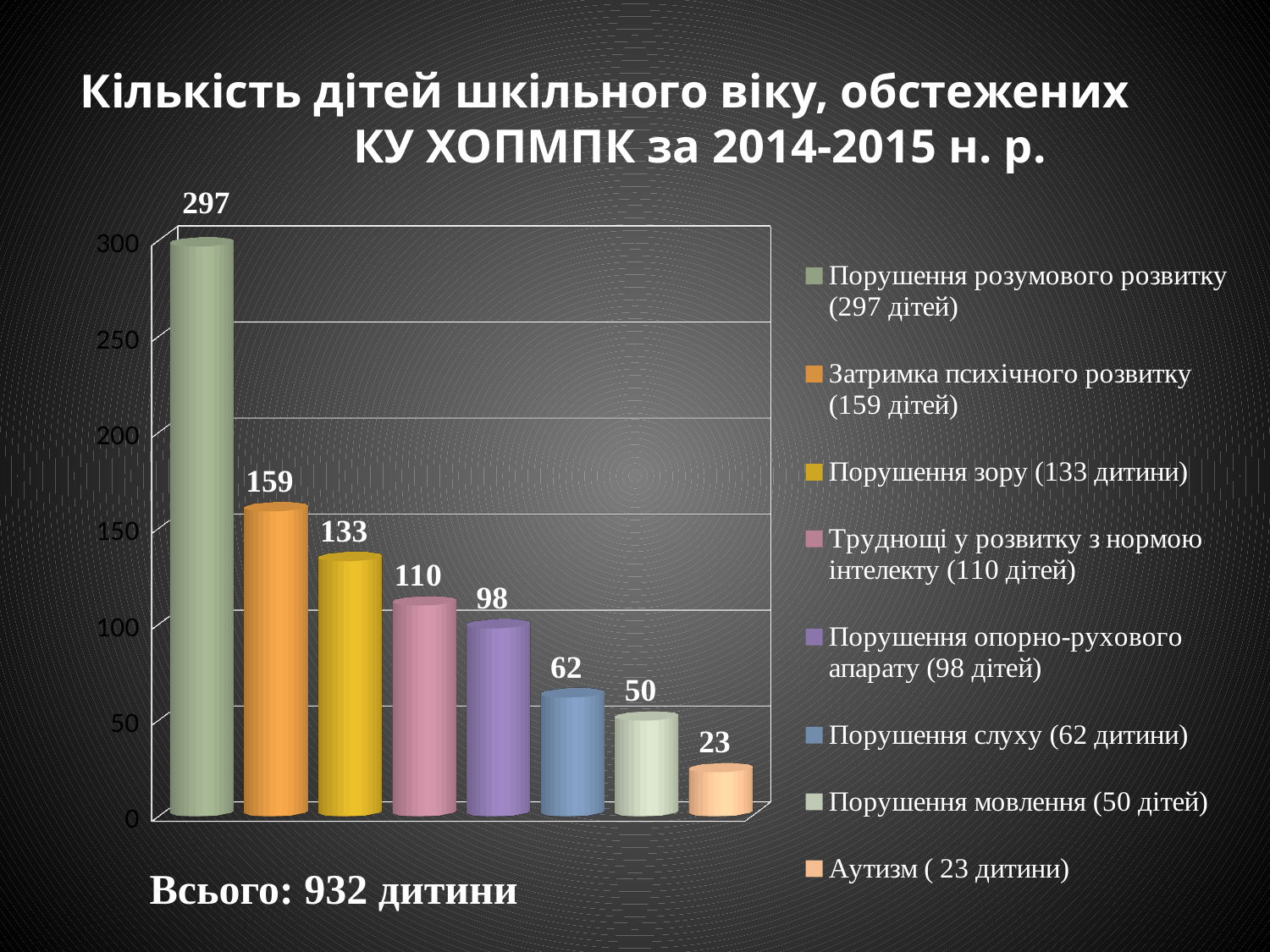
How many entries does the legend list? 8 Which is larger, the value for Труднощі у розвитку з нормою інтелекту or the value for Порушення опорно-рухового апарату? Труднощі у розвитку з нормою інтелекту What kind of chart is shown on the slide? bar chart What is the value for Аутизм? 23 How many bars are shown in the chart? 8 Do the values rise or fall from left to right across the bars? fall What is the value for Порушення слуху? 62 Which category has the highest value? Порушення розумового розвитку What is the difference between the values for Затримка психічного розвитку and Порушення зору? 26 Is the value for Порушення мовлення greater or less than 100? less What is the value for Порушення розумового розвитку? 297 Which category has the lowest value? Аутизм